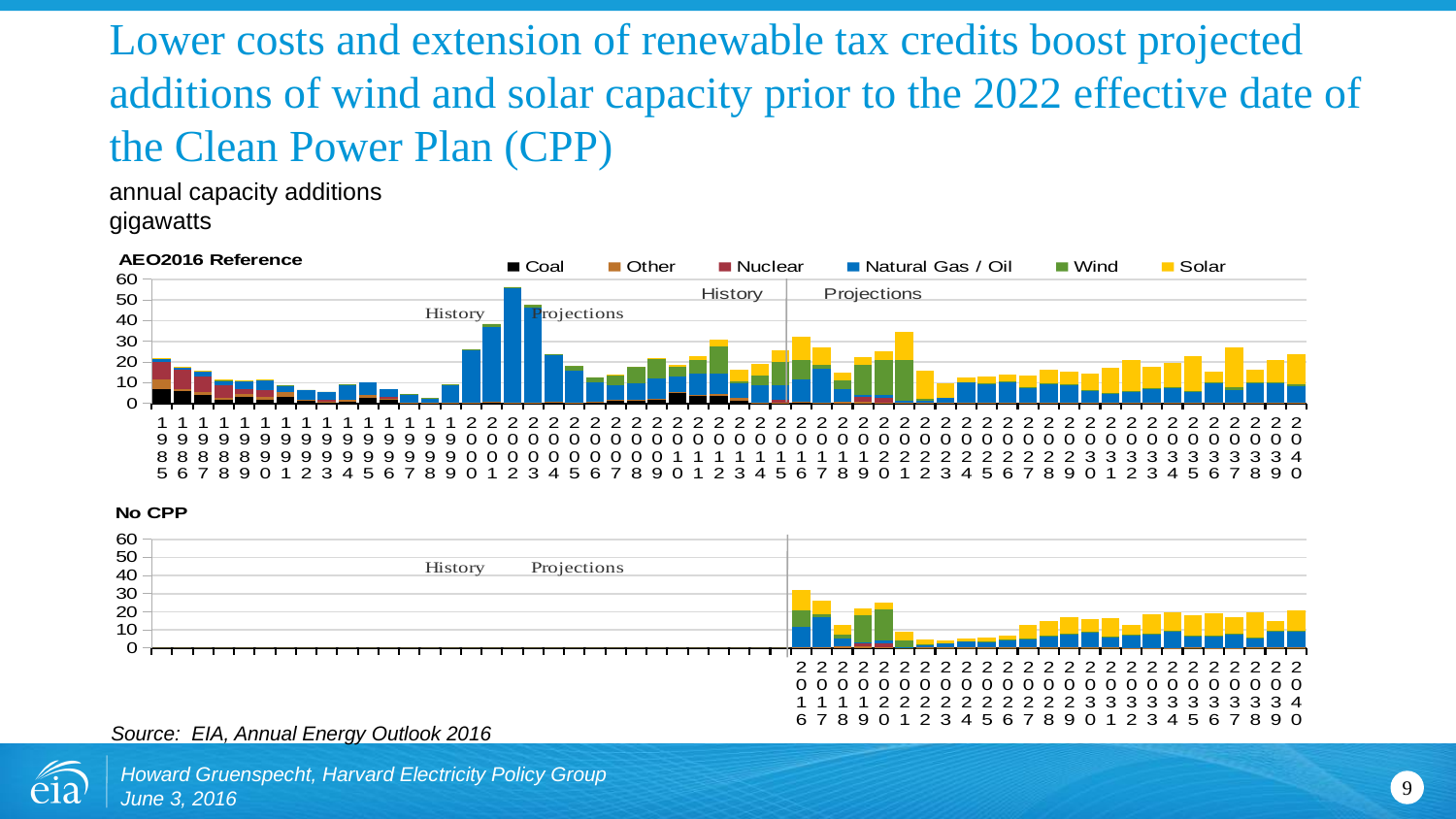
What unit is used on the y axis of the charts? gigawatts What is the highest value shown on the y axis of the AEO2016 Reference chart? 60 In the No CPP chart, which year has the highest total capacity additions? 2016 In the AEO2016 Reference chart, is the total for 2002 greater or less than 50? greater What kind of chart is the AEO2016 Reference chart? stacked bar chart In the AEO2016 Reference chart, which is larger, the total for 2002 or the total for 2010? 2002 How many series does the legend list? 6 In the No CPP chart, is the total for 2022 greater or less than 10? less In the No CPP chart, is the total for 2016 greater or less than 20? greater In the AEO2016 Reference chart, which year has the highest total capacity additions? 2002